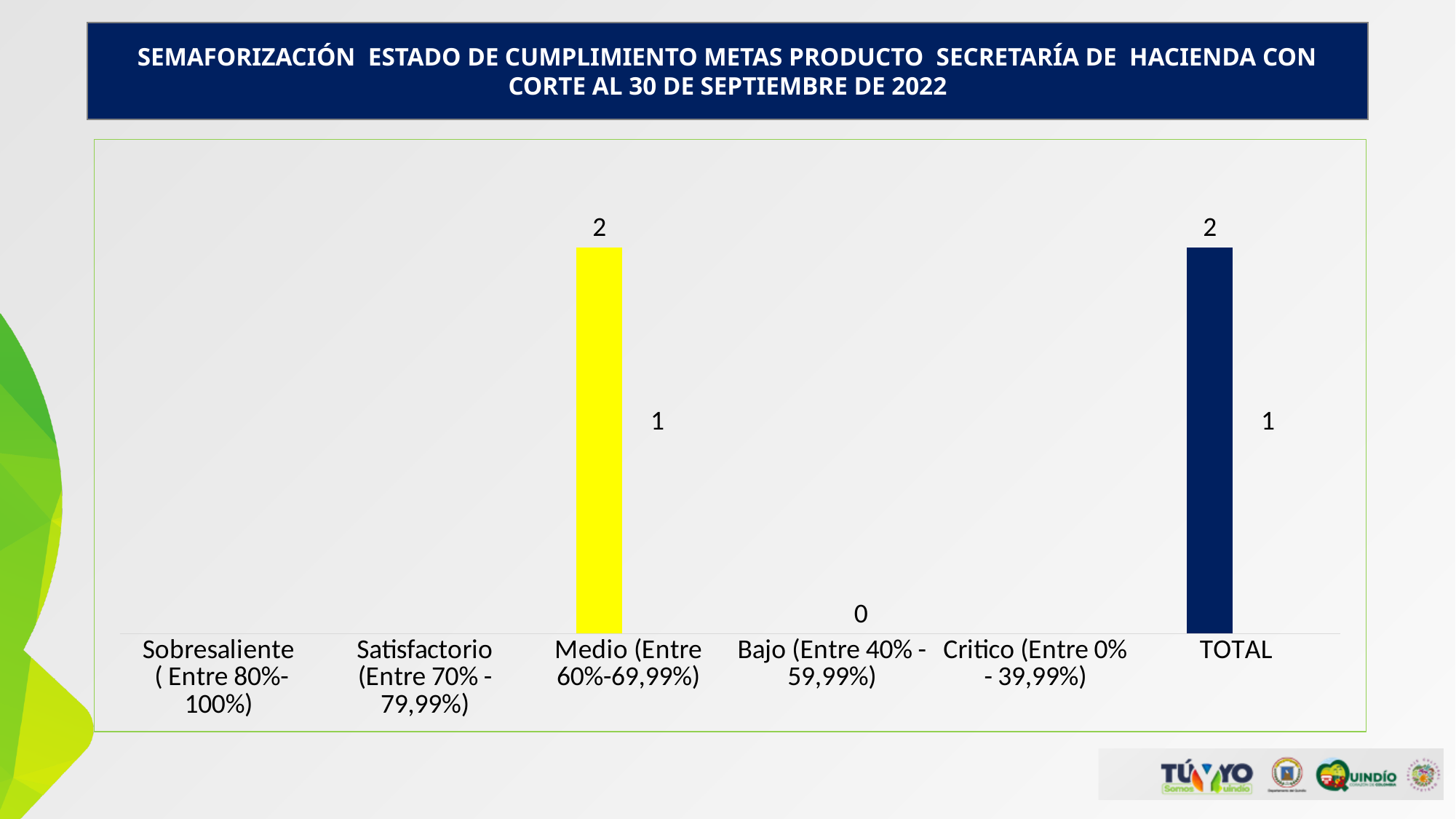
What value is labelled for Bajo (Entre 40% - 59,99%)? 0 What value is labelled on the bar for Medio (Entre 60%-69,99%)? 2 What kind of chart is shown on the slide? Bar chart How many categories are shown along the x axis of the chart? 6 Excluding TOTAL, which category has the tallest bar? Medio (Entre 60%-69,99%) What colour is the bar for Medio (Entre 60%-69,99%)? Yellow What colour is the TOTAL bar? Dark blue Is the value for TOTAL greater or less than 1? greater What is the difference between the value for Medio (Entre 60%-69,99%) and the value for Bajo (Entre 40% - 59,99%)? 2 Which is larger, the value for Medio (Entre 60%-69,99%) or the value for Bajo (Entre 40% - 59,99%)? Medio (Entre 60%-69,99%) What value is labelled on the TOTAL bar? 2